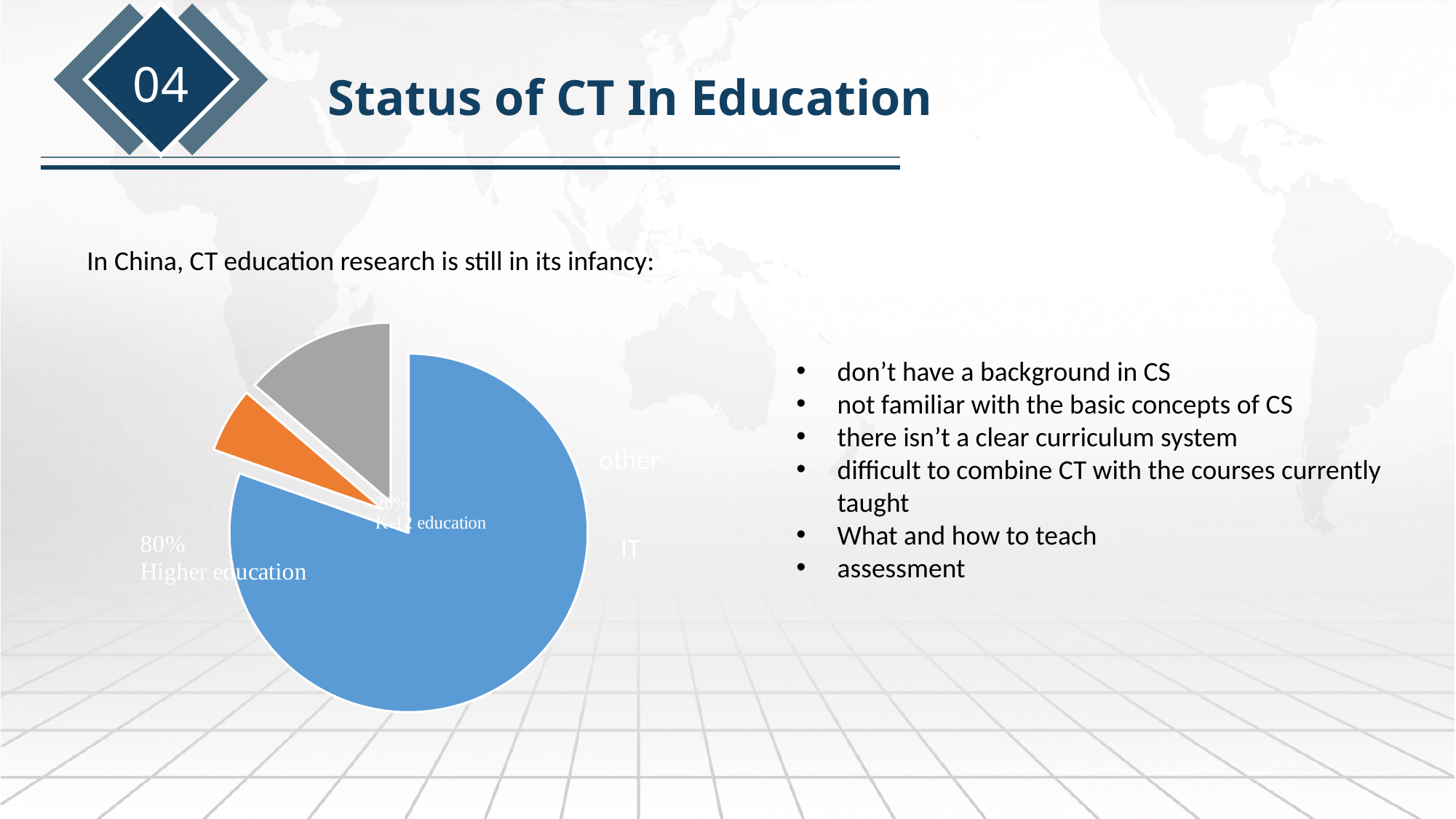
What share of the pie is labelled Higher education? 80% What colour is the Higher education slice in the pie chart? blue How many slices does the pie chart have? 3 Is the share for Higher education greater or less than 50%? greater What kind of chart is shown on the slide? pie chart How many slices are pulled out (exploded) from the pie chart? 2 Which is larger in the pie chart, the Higher education slice or the K-12 education slice? Higher education Which slice of the pie chart is the largest? Higher education